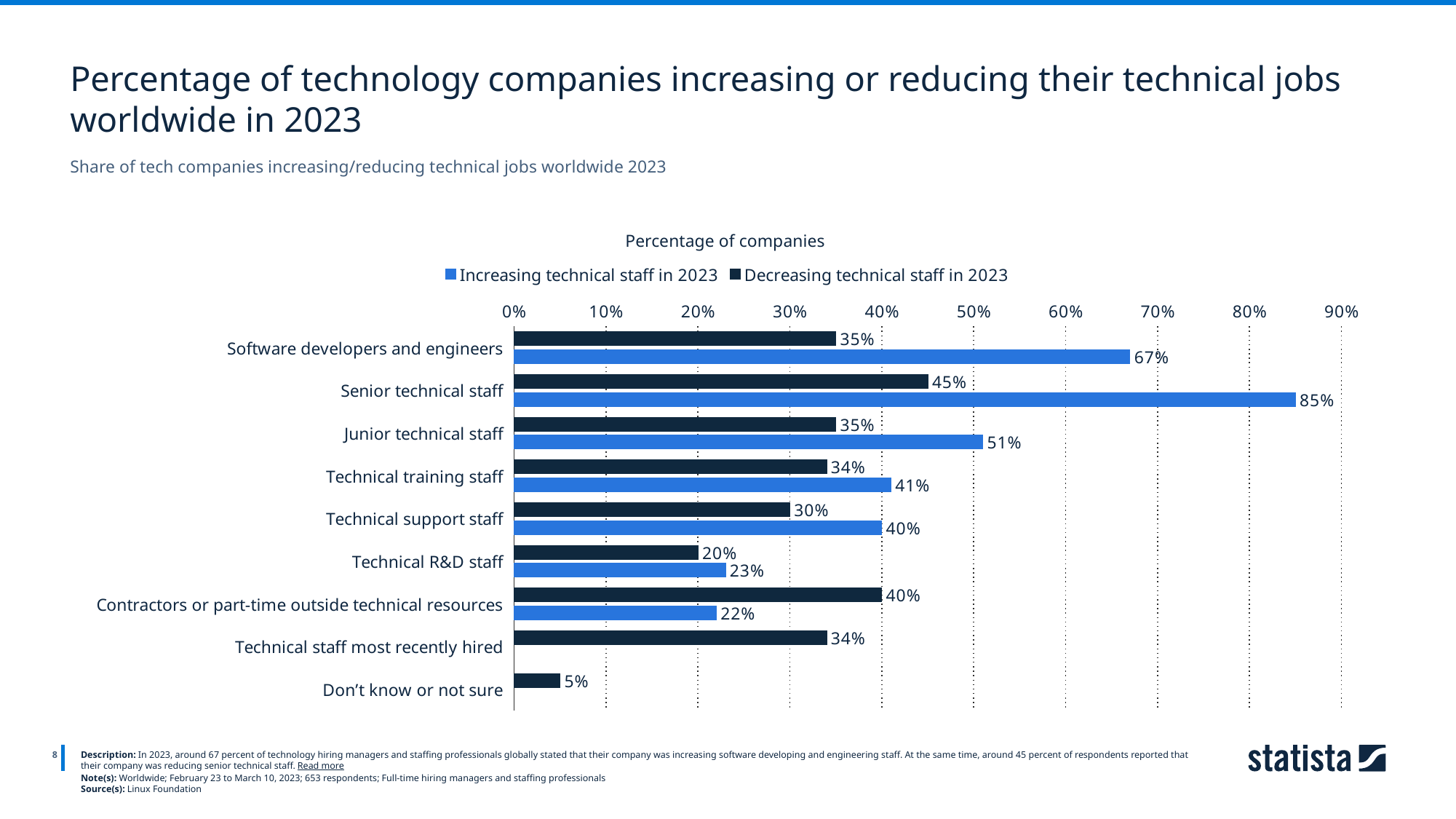
Which colour represents 'Increasing technical staff in 2023' in the legend? Blue What type of chart is shown on the slide? Bar chart How many series does the legend list? 2 What percentage of companies reported increasing software developers and engineers in 2023? 67% What is the difference between the increasing and decreasing values for junior technical staff? 16% Which category has the highest value for 'Increasing technical staff in 2023'? Senior technical staff What is the value for 'Increasing technical staff in 2023' for contractors or part-time outside technical resources? 22% What percentage of companies reported decreasing senior technical staff in 2023? 45% For contractors or part-time outside technical resources, which is larger: the increasing value or the decreasing value? Decreasing technical staff in 2023 How many categories are shown on the chart? 9 Which category has the lowest value for 'Decreasing technical staff in 2023'? Don't know or not sure What is the value for 'Decreasing technical staff in 2023' for technical staff most recently hired? 34%